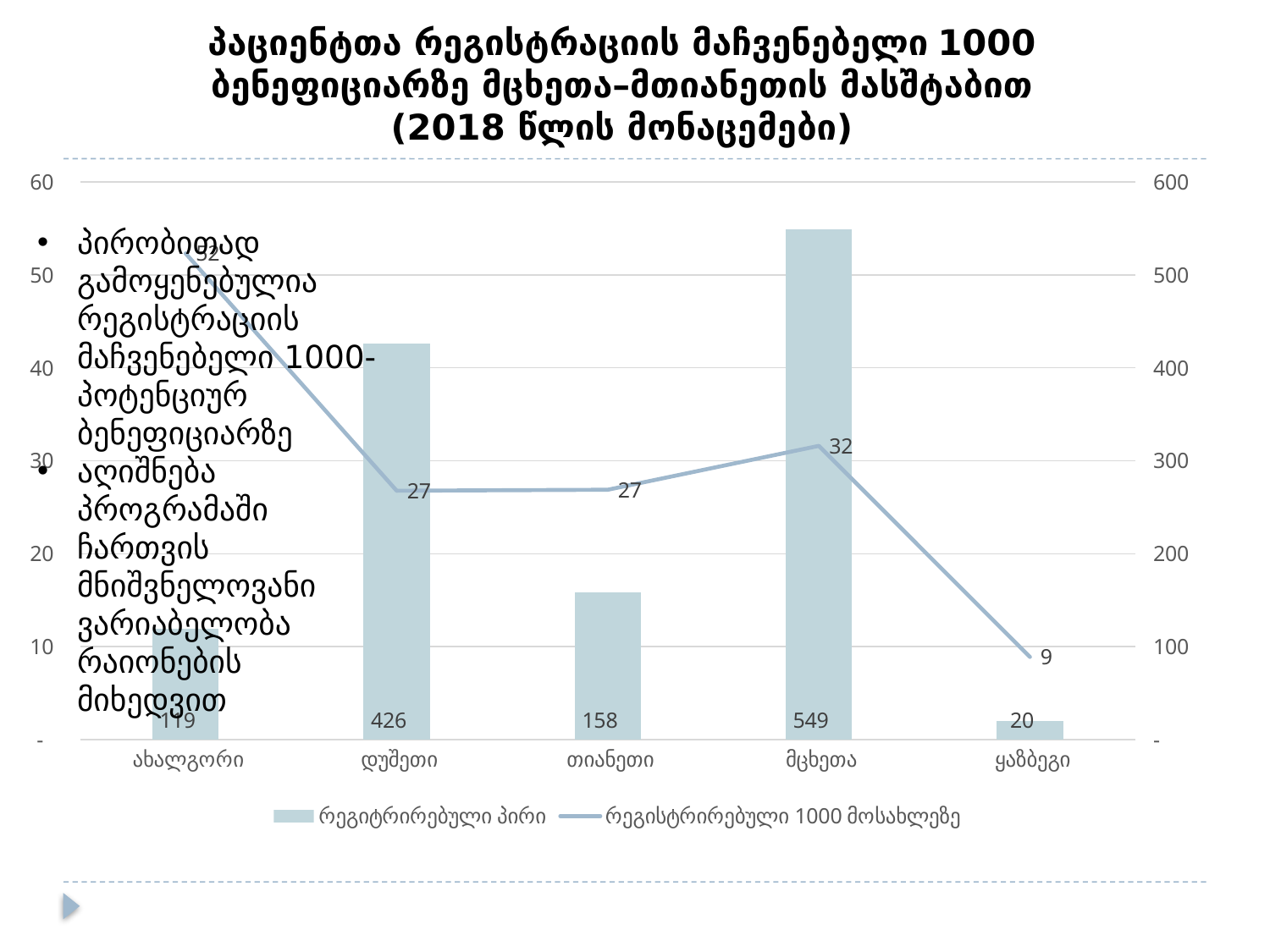
What is the difference between the რეგიტრირებული პირი values for მცხეთა and დუშეთი? 123 Which category has the lowest რეგიტრირებული პირი bar? ყაზბეგი Which series is drawn as a line rather than bars? რეგისტრირებული 1000 მოსახლეზე What is the value of the რეგისტრირებული 1000 მოსახლეზე line for ყაზბეგი? 9 What is the value of the რეგისტრირებული 1000 მოსახლეზე line for მცხეთა? 32 What is the value of the რეგიტრირებული პირი bar for მცხეთა? 549 How many series does the legend list? 2 What is the value of the რეგიტრირებული პირი bar for დუშეთი? 426 How many categories are shown on the x axis? 5 Which category has the highest რეგიტრირებული პირი bar? მცხეთა Which category has the lowest value on the რეგისტრირებული 1000 მოსახლეზე line? ყაზბეგი Which is larger, the რეგიტრირებული პირი value for თიანეთი or for ახალგორი? თიანეთი